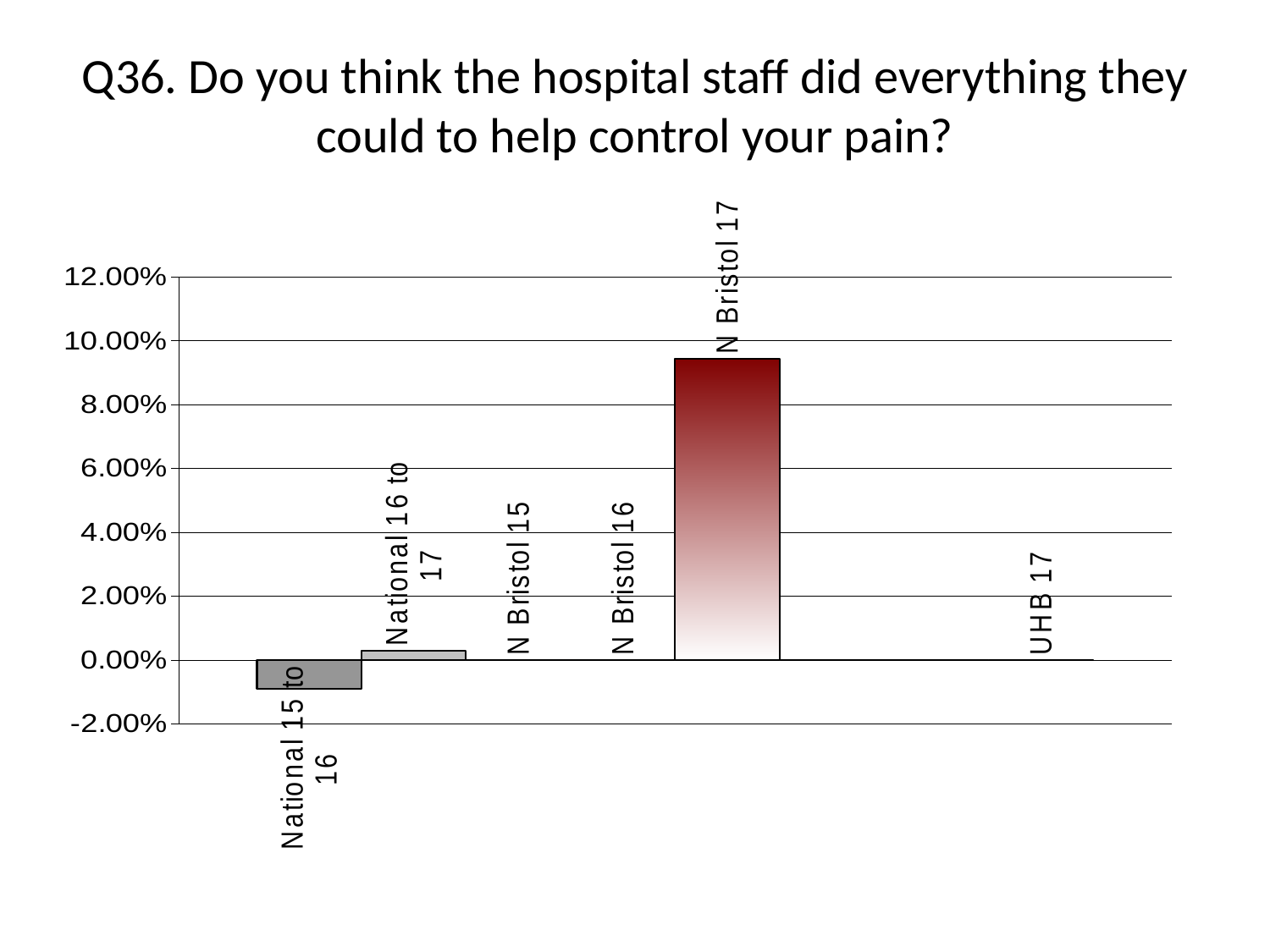
Is the value for National 15 to 16 greater or less than 0.00%? less Is the value for N Bristol 17 greater or less than 8.00%? greater How many categories are shown on the x axis of the chart? 6 Which category has the highest value in the chart? N Bristol 17 Is the value for National 16 to 17 greater or less than 2.00%? less What kind of chart is shown on the slide? bar chart What is the title of the slide? Q36. Do you think the hospital staff did everything they could to help control your pain? What is the highest value shown on the y axis of the chart? 12.00% Which is larger, the value for National 16 to 17 or the value for National 15 to 16? National 16 to 17 Which category has the lowest value in the chart? National 15 to 16 Which is larger, the value for N Bristol 17 or the value for National 16 to 17? N Bristol 17